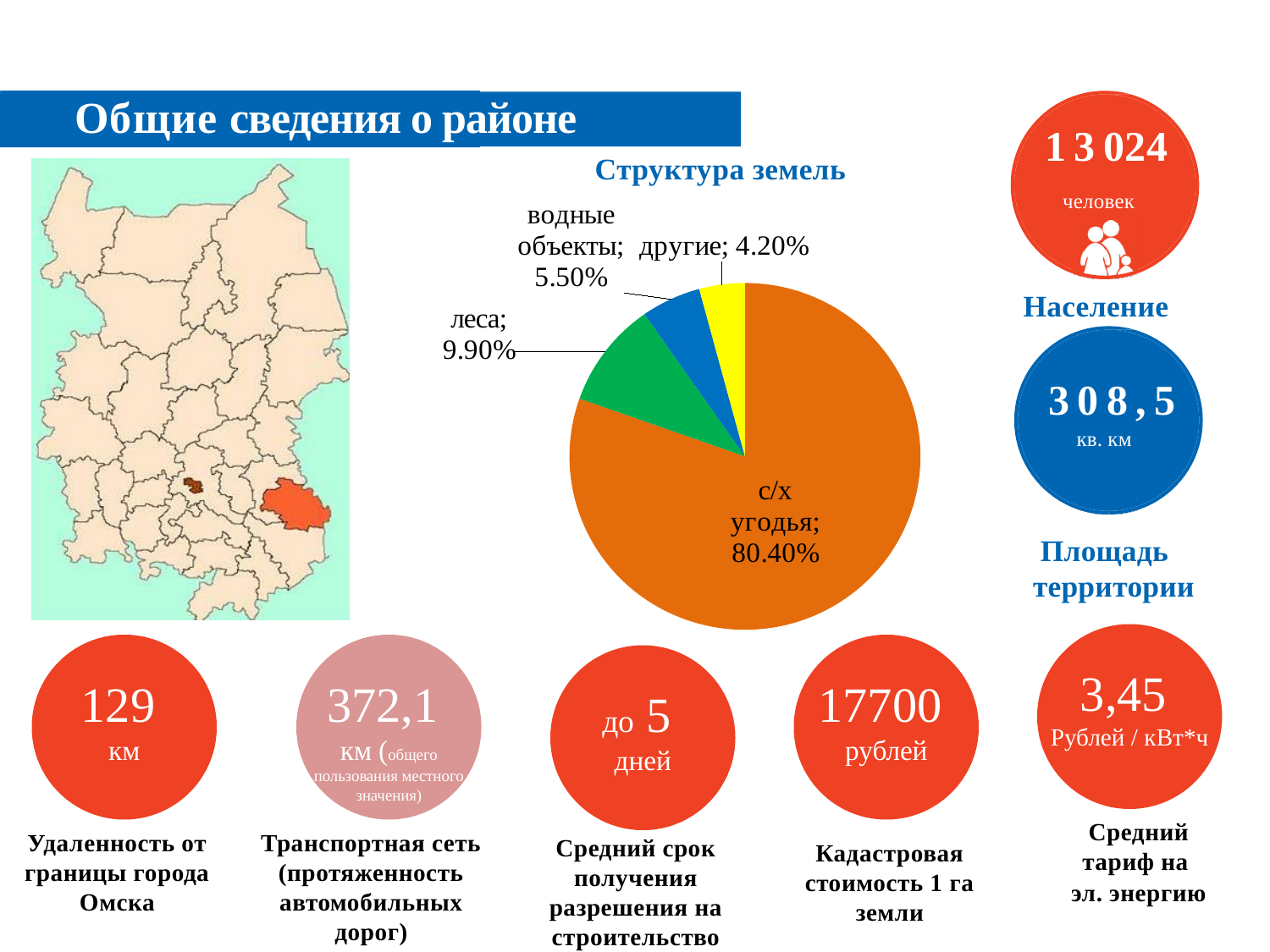
What colour is the 'с/х угодья' slice in the 'Структура земель' pie chart? orange Which category has the smallest slice in the 'Структура земель' pie chart? другие What is the share of 'с/х угодья' in the 'Структура земель' pie chart? 80.40% What is the share of 'другие' in the 'Структура земель' pie chart? 4.20% What is the share of 'водные объекты' in the 'Структура земель' pie chart? 5.50% How many slices does the 'Структура земель' pie chart have? 4 In the 'Структура земель' pie chart, what is the difference in percentage points between 'леса' and 'водные объекты'? 4.40% What is the share of 'леса' in the 'Структура земель' pie chart? 9.90% Which category has the largest slice in the 'Структура земель' pie chart? с/х угодья In the 'Структура земель' pie chart, which is larger: 'водные объекты' or 'другие'? водные объекты What is the title of the pie chart on the slide? Структура земель What type of chart is used to show the 'Структура земель'? pie chart